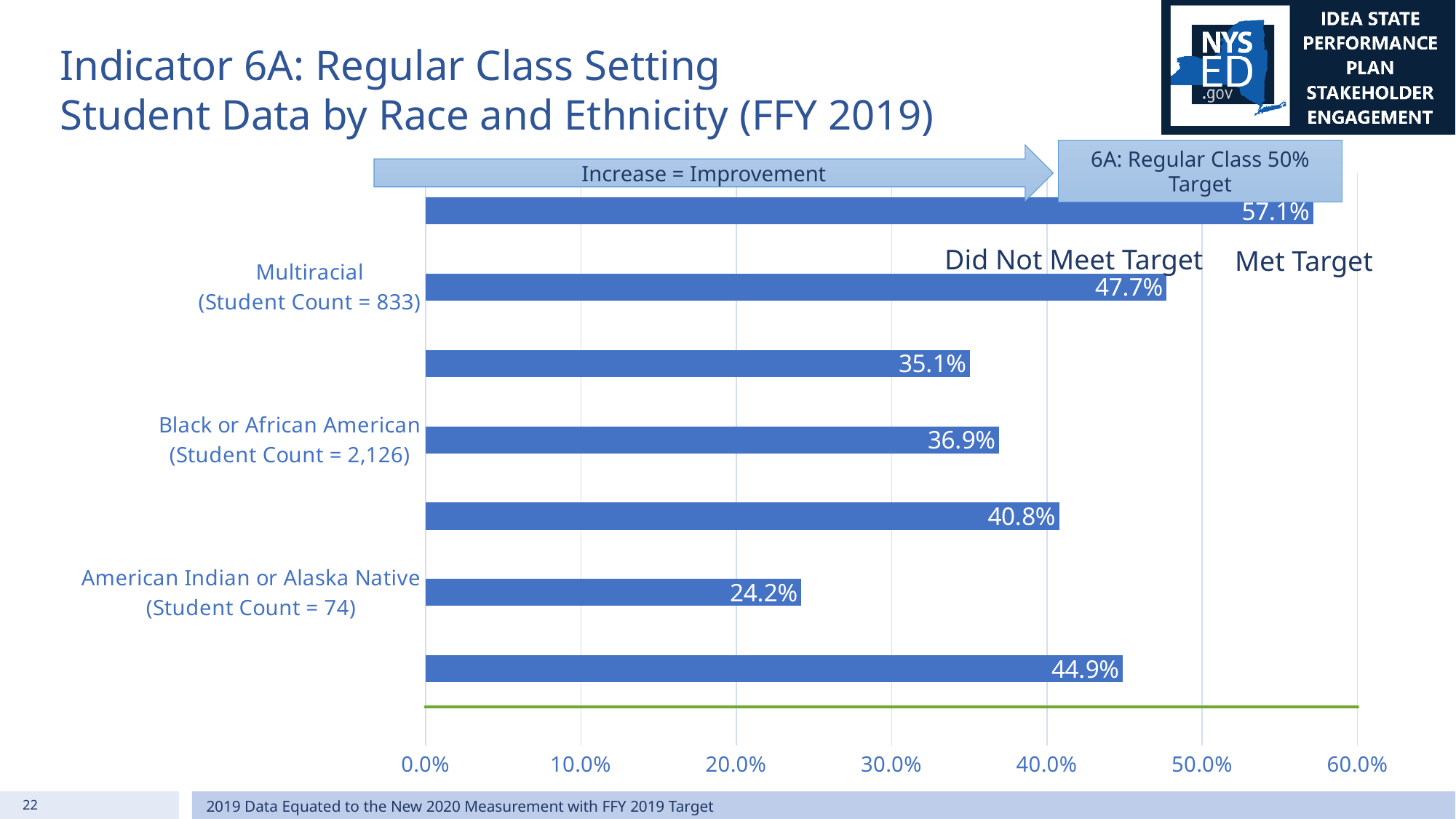
What is the value for American Indian or Alaska Native (Student Count = 74)? 24.2% Is the value for Multiracial greater or less than 50.0%? less What is the difference between the values for Multiracial and Black or African American? 10.8 percentage points Which labeled category has the lowest value? American Indian or Alaska Native (Student Count = 74) What target percentage is stated for Indicator 6A Regular Class? 50% What is the value for Multiracial (Student Count = 833)? 47.7% What kind of chart is shown on the slide? Bar chart How many bars are plotted on the chart? 7 What is the value for Black or African American (Student Count = 2,126)? 36.9% What is the highest value shown by any bar on the chart? 57.1% Which is larger, the value for Multiracial or the value for American Indian or Alaska Native? Multiracial Is the value for Black or African American greater or less than 30.0%? greater